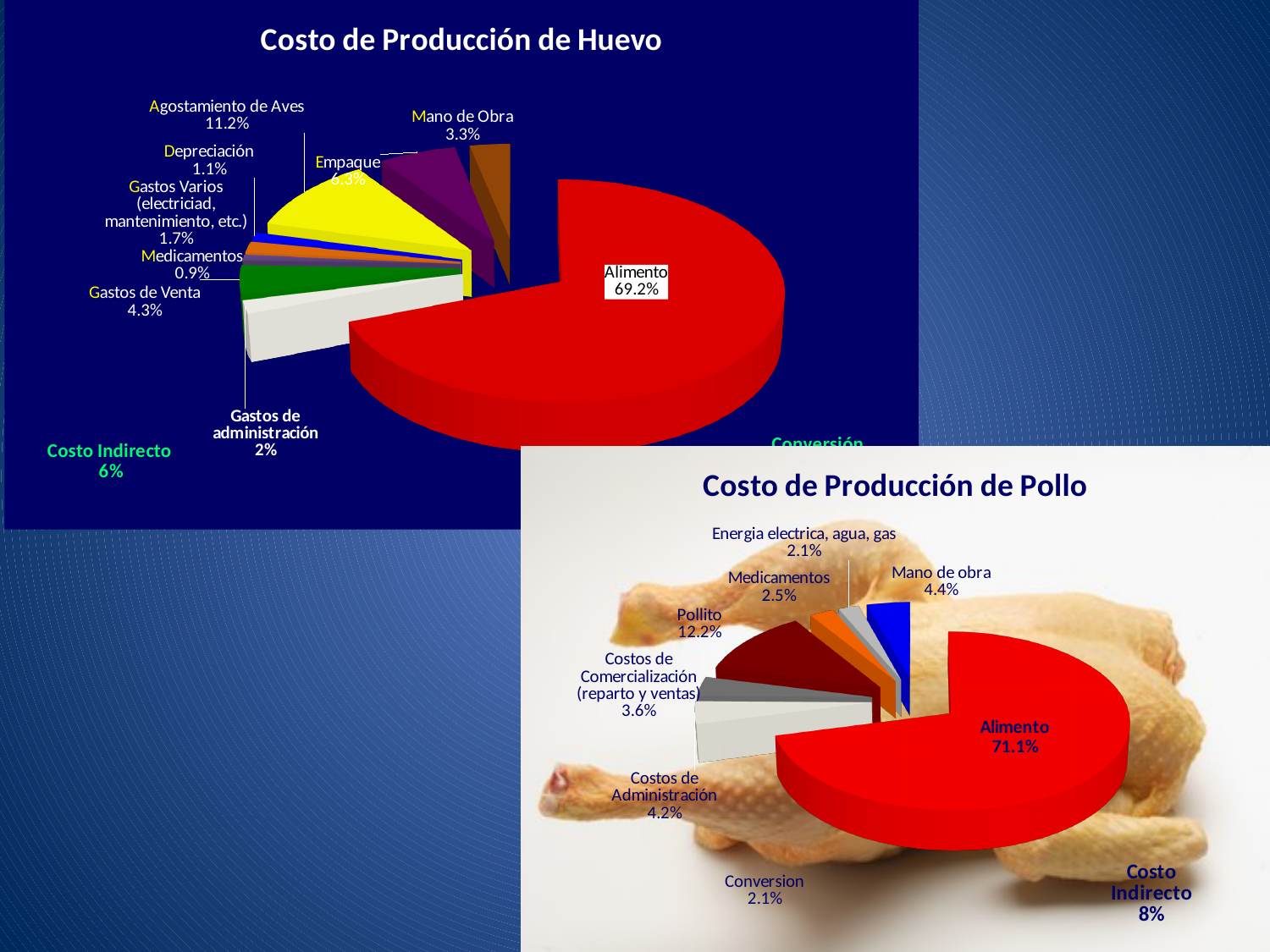
In the 'Costo de Producción de Huevo' chart, what percentage is Gastos de Venta? 4.3% In the 'Costo de Producción de Pollo' chart, what percentage is Pollito? 12.2% In the 'Costo de Producción de Huevo' chart, what is the difference between Mano de Obra and Depreciación? 2.2% In the 'Costo de Producción de Pollo' chart, which is larger, Costos de Administración or Costos de Comercialización? Costos de Administración In the 'Costo de Producción de Huevo' chart, what percentage is Alimento? 69.2% What type of chart is 'Costo de Producción de Pollo'? Pie chart In the 'Costo de Producción de Pollo' chart, which category has the largest share? Alimento In the 'Costo de Producción de Huevo' chart, what percentage is Agostamiento de Aves? 11.2% In the 'Costo de Producción de Huevo' chart, which category has the smallest share? Medicamentos In the 'Costo de Producción de Pollo' chart, what percentage is Mano de obra? 4.4% In the 'Costo de Producción de Pollo' chart, what is the difference between Alimento and Pollito? 58.9% In the 'Costo de Producción de Huevo' chart, which category has the largest share? Alimento